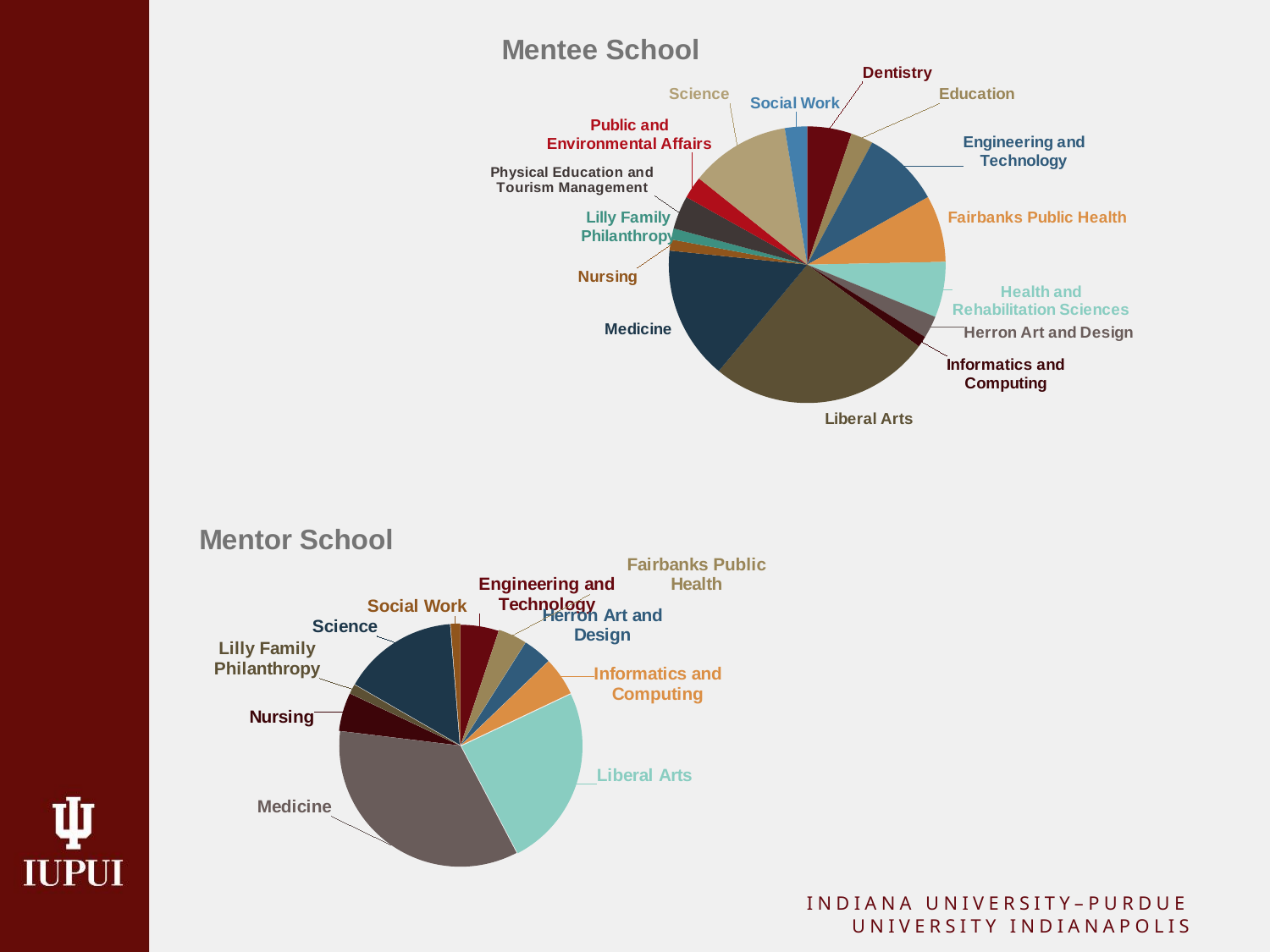
What kind of chart is the Mentee School chart? Pie chart In the Mentee School chart, which school has the largest slice? Liberal Arts How many schools are shown as slices in the Mentor School pie chart? 10 In the Mentee School chart, which slice is larger, Engineering and Technology or Dentistry? Engineering and Technology What kind of chart is the Mentor School chart? Pie chart In the Mentor School chart, which slice is larger, Medicine or Nursing? Medicine In the Mentee School chart, which slice is larger, Medicine or Science? Medicine In the Mentor School chart, which school has the largest slice? Medicine How many schools are shown as slices in the Mentee School pie chart? 15 How many pie charts are on the slide? 2 What is the title of the upper pie chart on the slide? Mentee School